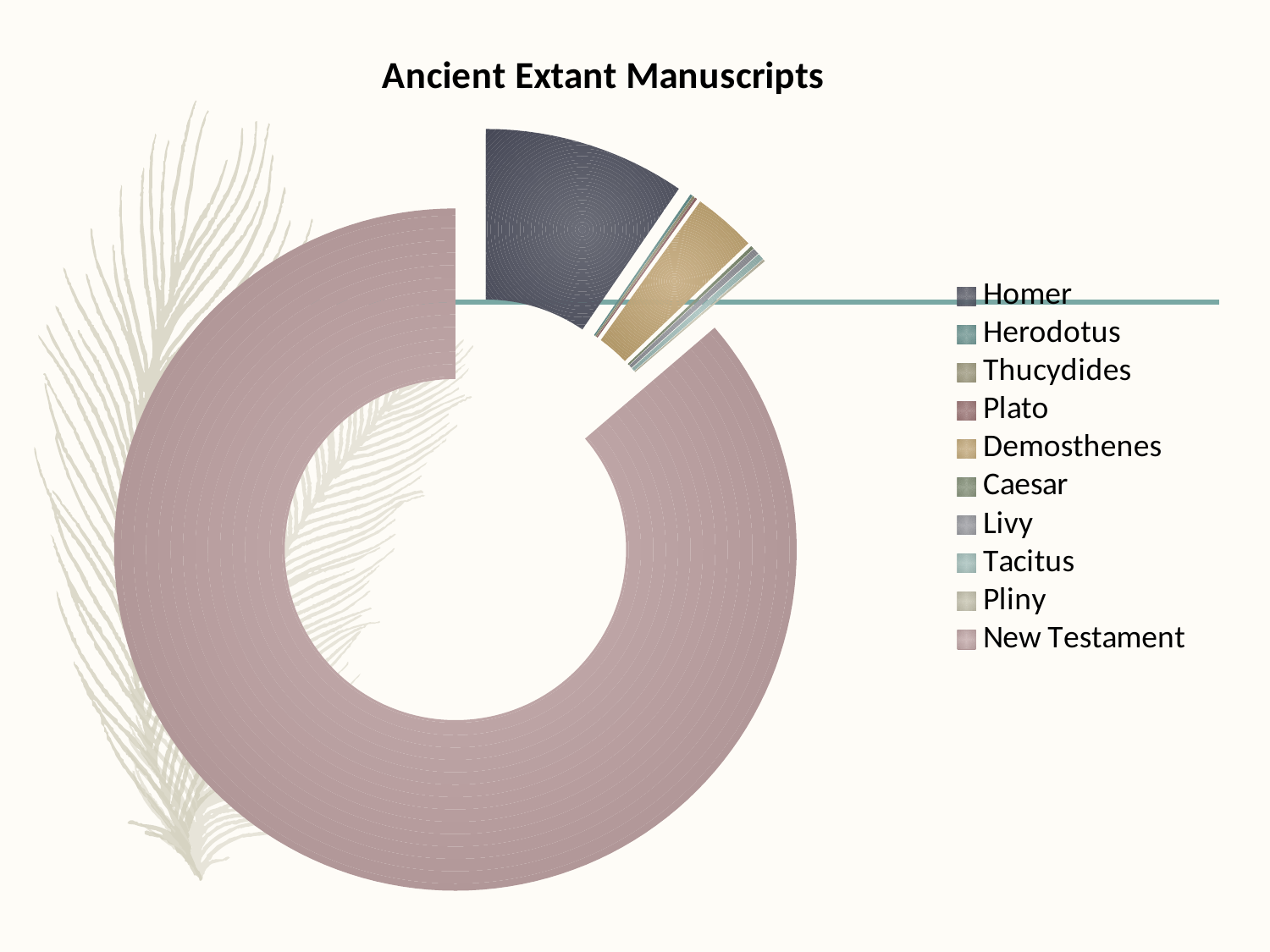
What is the title of the chart? Ancient Extant Manuscripts How many categories does the legend of the chart list? 10 Which slice is larger, Demosthenes or Herodotus? Demosthenes What kind of chart is shown on the slide? doughnut chart Which category has the largest slice in the chart? New Testament Which slice is larger, New Testament or Homer? New Testament Which category is the second-largest slice in the chart? Homer Which slice is larger, Homer or Demosthenes? Homer Which category is the last entry listed in the legend? New Testament